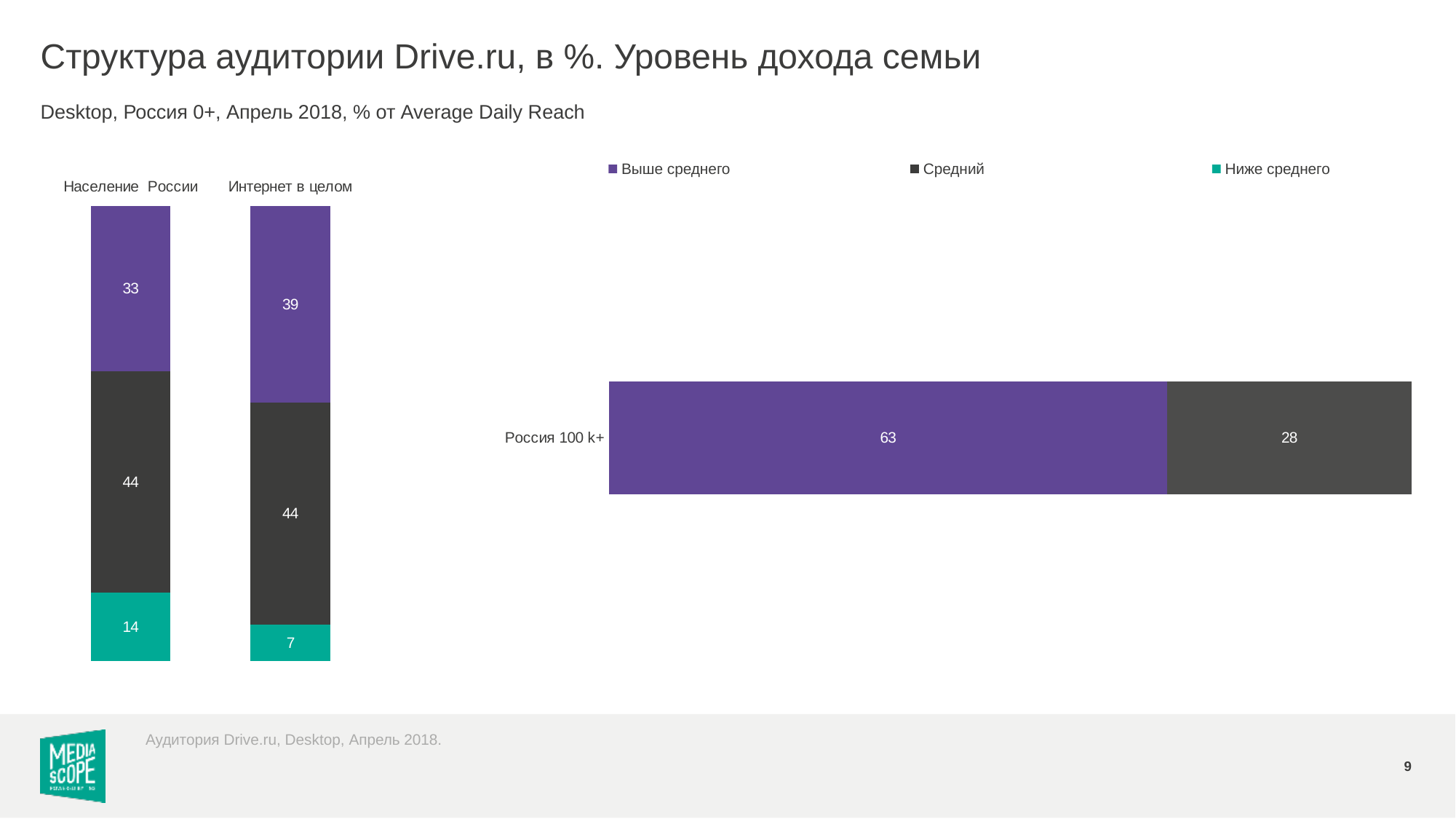
What kind of chart is shown on the right side of the slide? Bar chart In the left chart, which segment is the largest for 'Население России'? Средний In the right chart, what is the value of the 'Выше среднего' segment for 'Россия 100 k+'? 63 In the left chart, what is the difference between the 'Ниже среднего' values for 'Население России' and 'Интернет в целом'? 7 How many series does the legend list? 3 In the left chart, which has a larger 'Выше среднего' value: 'Население России' or 'Интернет в целом'? Интернет в целом In the left chart, what is the value of the 'Средний' segment for 'Интернет в целом'? 44 In the left chart, what is the value of the 'Ниже среднего' segment for 'Интернет в целом'? 7 In the left chart, which segment is the smallest for 'Интернет в целом'? Ниже среднего In the right chart, what is the value of the 'Средний' segment for 'Россия 100 k+'? 28 In the left chart, what is the value of the 'Выше среднего' segment for 'Население России'? 33 In the left chart, what is the total of the stacked bar for 'Население России'? 91